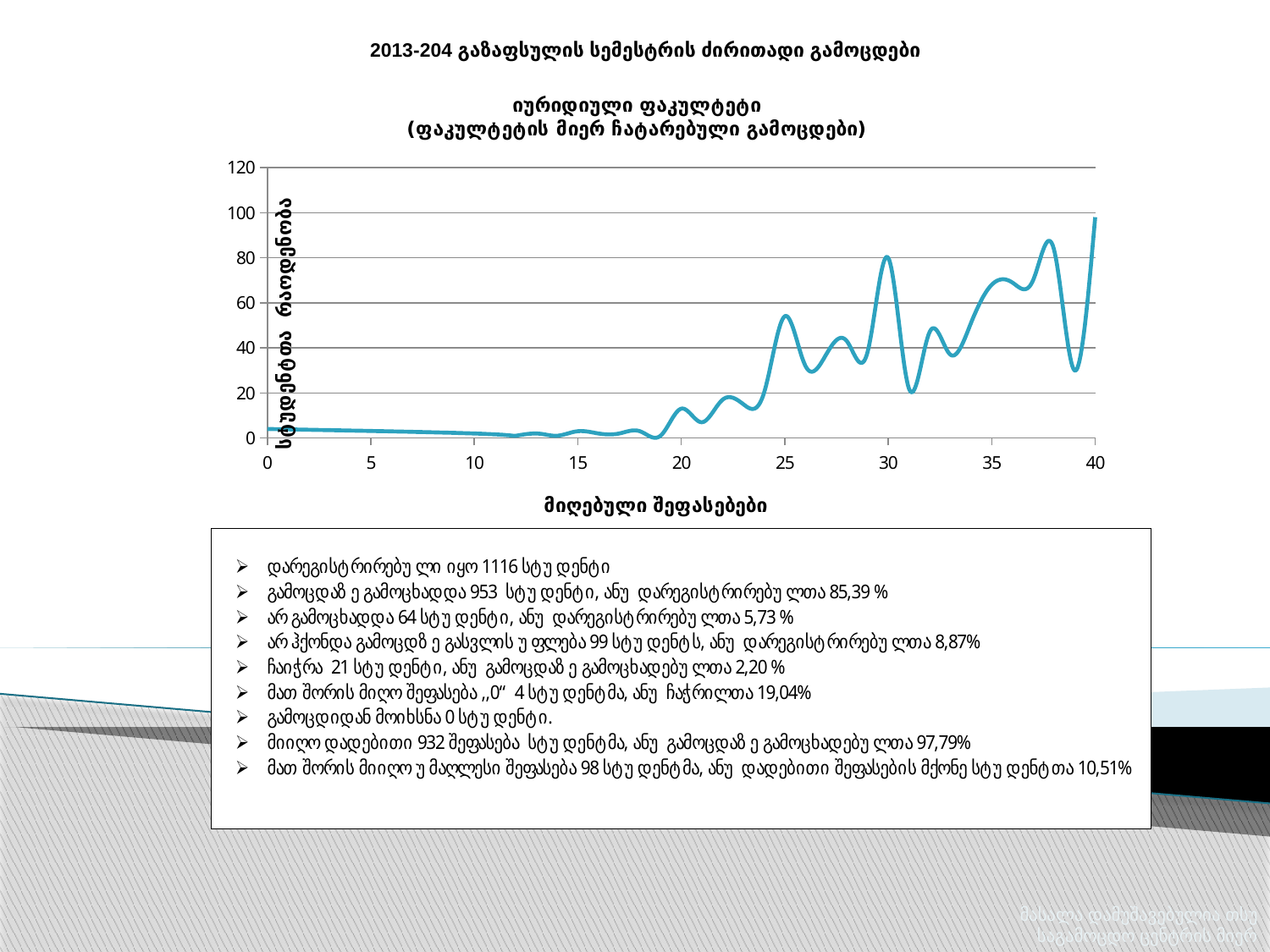
What is the highest value shown on the y axis? 120 What is the label of the x axis? მიღებული შეფასებები Is the value at score 25 greater or less than 40? greater Overall, do the values rise or fall as the score increases from 0 to 40? rise What kind of chart is shown on the slide? line chart Is the value at score 35 greater or less than 60? greater Is the value at score 10 greater or less than 20? less Is the value at score 40 greater or less than the value at score 5? greater